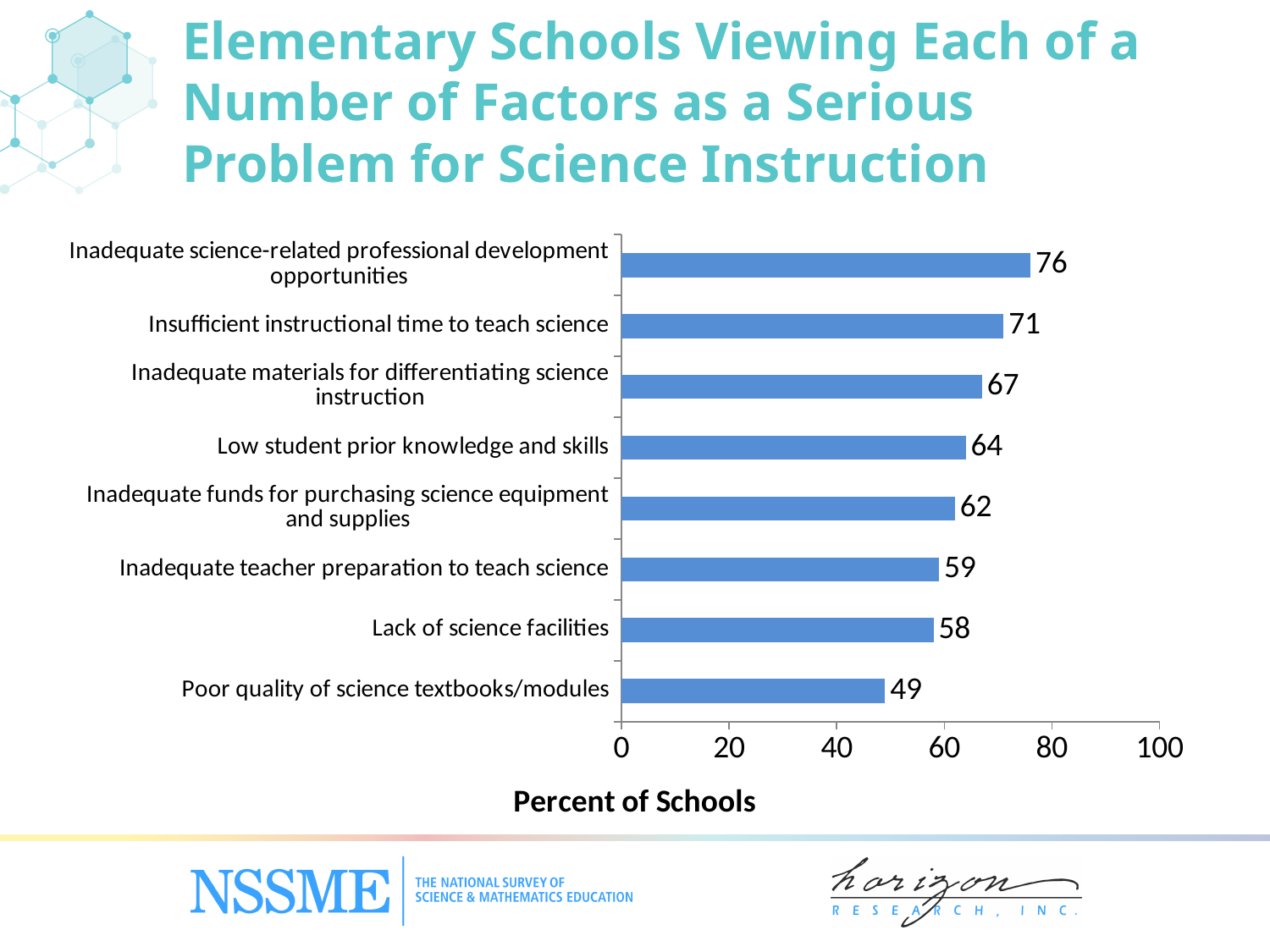
What is the difference between the highest and lowest values in the chart? 27 Which is larger: the value for 'Inadequate funds for purchasing science equipment and supplies' or 'Inadequate teacher preparation to teach science'? Inadequate funds for purchasing science equipment and supplies What is the value for 'Lack of science facilities'? 58 What percent of schools view inadequate science-related professional development opportunities as a serious problem? 76 Which factor has the lowest percent of schools viewing it as a serious problem? Poor quality of science textbooks/modules Is the value for 'Inadequate materials for differentiating science instruction' greater or less than 60? greater Which factor has the highest percent of schools viewing it as a serious problem? Inadequate science-related professional development opportunities What is the difference between the values for 'Insufficient instructional time to teach science' and 'Poor quality of science textbooks/modules'? 22 What is the label of the horizontal axis? Percent of Schools What kind of chart is shown on the slide? Bar chart What is the value for 'Low student prior knowledge and skills'? 64 How many factors are shown in the chart? 8